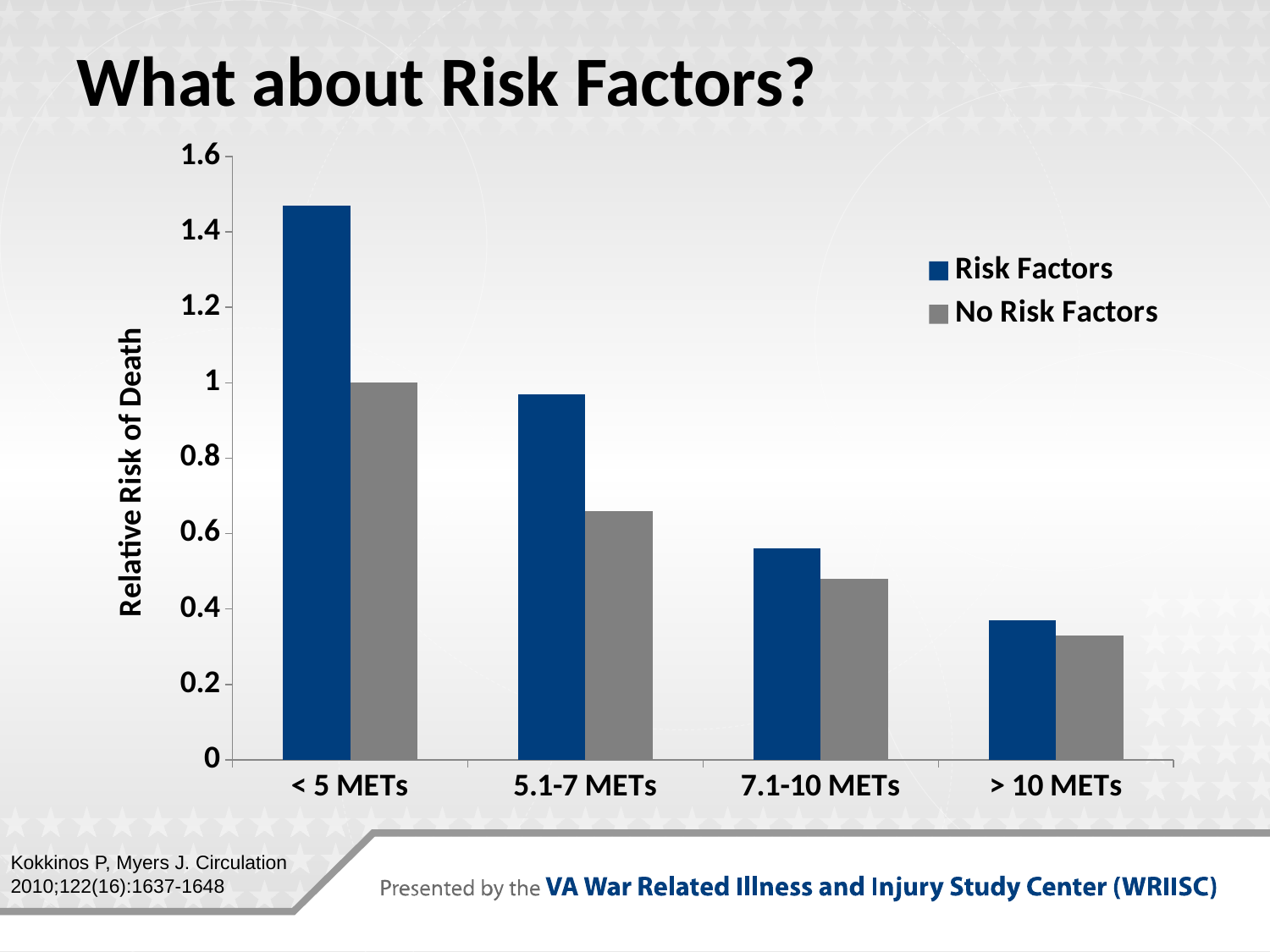
Do the Risk Factors values rise or fall as the MET categories increase along the x axis? fall Which MET category has the lowest No Risk Factors value? > 10 METs Which MET category has the highest Risk Factors value? < 5 METs Is the Risk Factors value for > 10 METs greater or less than 0.4? less How many series does the legend list? 2 Is the Risk Factors value for 5.1-7 METs greater or less than 1? less What is the label of the y axis? Relative Risk of Death How many MET categories are shown on the x axis? 4 Is the Risk Factors value for < 5 METs greater or less than 1.4? greater What kind of chart is shown on the slide? bar chart For 5.1-7 METs, which is larger: the Risk Factors value or the No Risk Factors value? Risk Factors